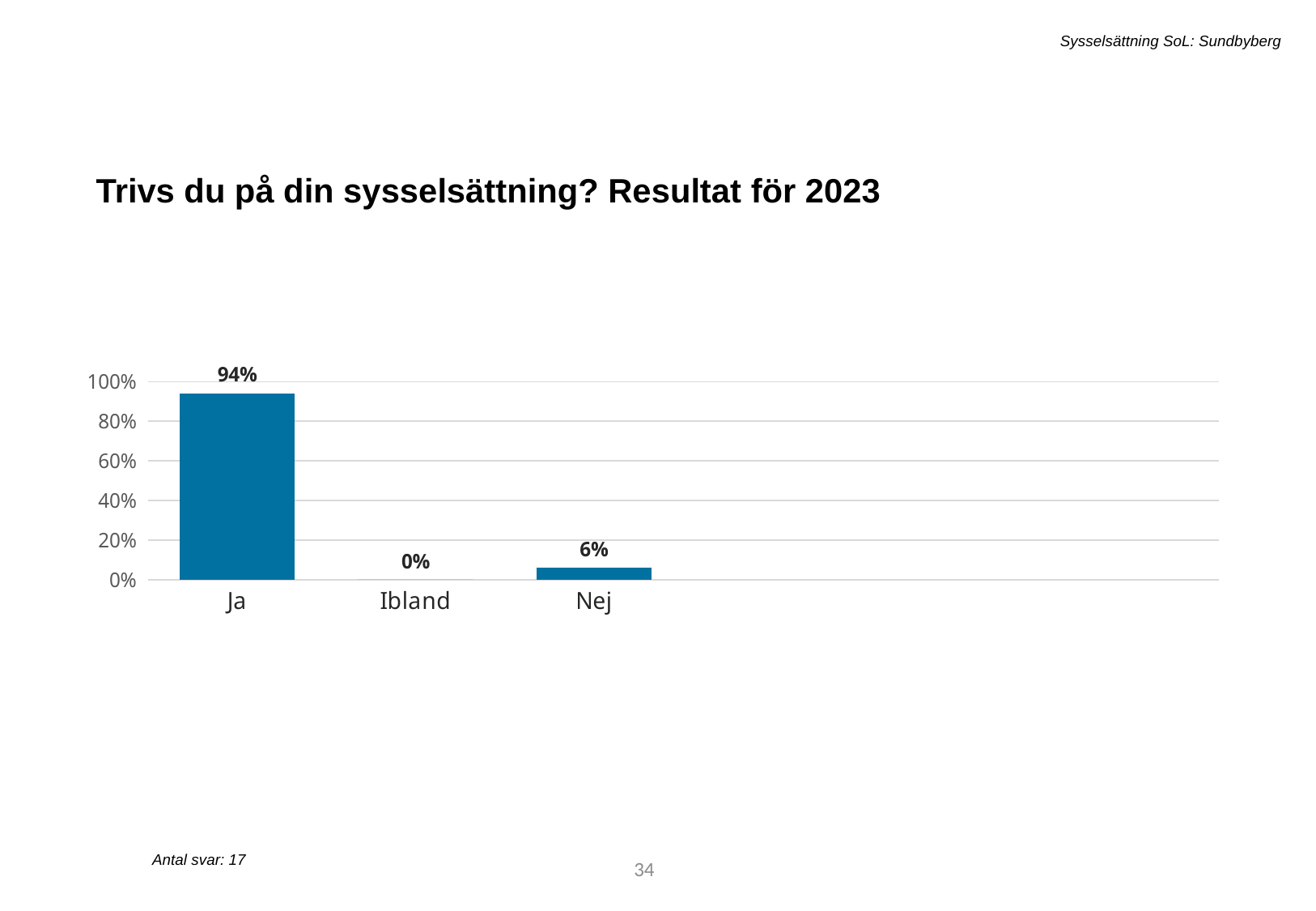
What is the value for Ibland? 0% What is the difference between the values for Ja and Nej? 88% Which is larger, the value for Nej or the value for Ibland? Nej Is the value for Ja greater or less than 80%? greater What kind of chart is shown on the slide? bar chart What is the value for Nej? 6% Which category has the highest value? Ja Is the value for Nej greater or less than 20%? less What is the value for Ja? 94% How many categories are shown on the x axis? 3 Which category has the lowest value? Ibland What is the title of the slide? Trivs du på din sysselsättning? Resultat för 2023